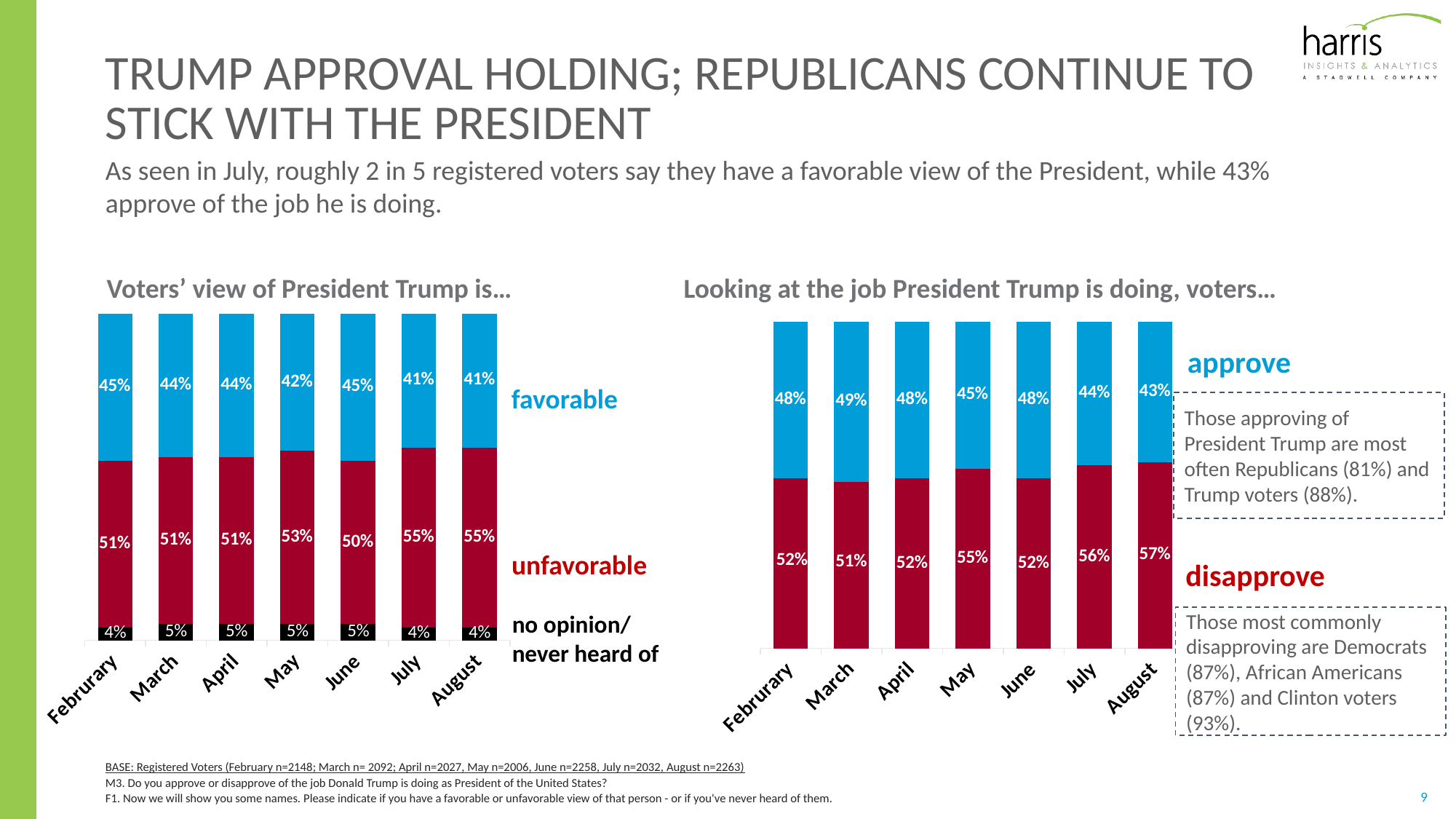
In the chart 'Looking at the job President Trump is doing, voters…', which month has the lowest approve value? August In the chart 'Looking at the job President Trump is doing, voters…', what is the disapprove value for August? 57% In the chart 'Voters' view of President Trump is…', which month has the highest unfavorable value? July and August (55%) In the chart 'Voters' view of President Trump is…', what is the 'no opinion/never heard of' value for March? 5% In the chart 'Voters' view of President Trump is…', what is the unfavorable value for August? 55% In the chart 'Looking at the job President Trump is doing, voters…', what percentage approved in March? 49% In the chart 'Voters' view of President Trump is…', how many months are shown on the x axis? 7 What type of chart is used on the right side of the slide, 'Looking at the job President Trump is doing, voters…'? Stacked bar chart In the chart 'Looking at the job President Trump is doing, voters…', what is the difference between disapprove and approve in July? 12 percentage points In the chart 'Looking at the job President Trump is doing, voters…', is the approve value higher in February or in July? February In the chart 'Voters' view of President Trump is…', what percentage of voters had a favorable view in February? 45% In the chart 'Voters' view of President Trump is…', what is the difference between the unfavorable and favorable values in August? 14 percentage points